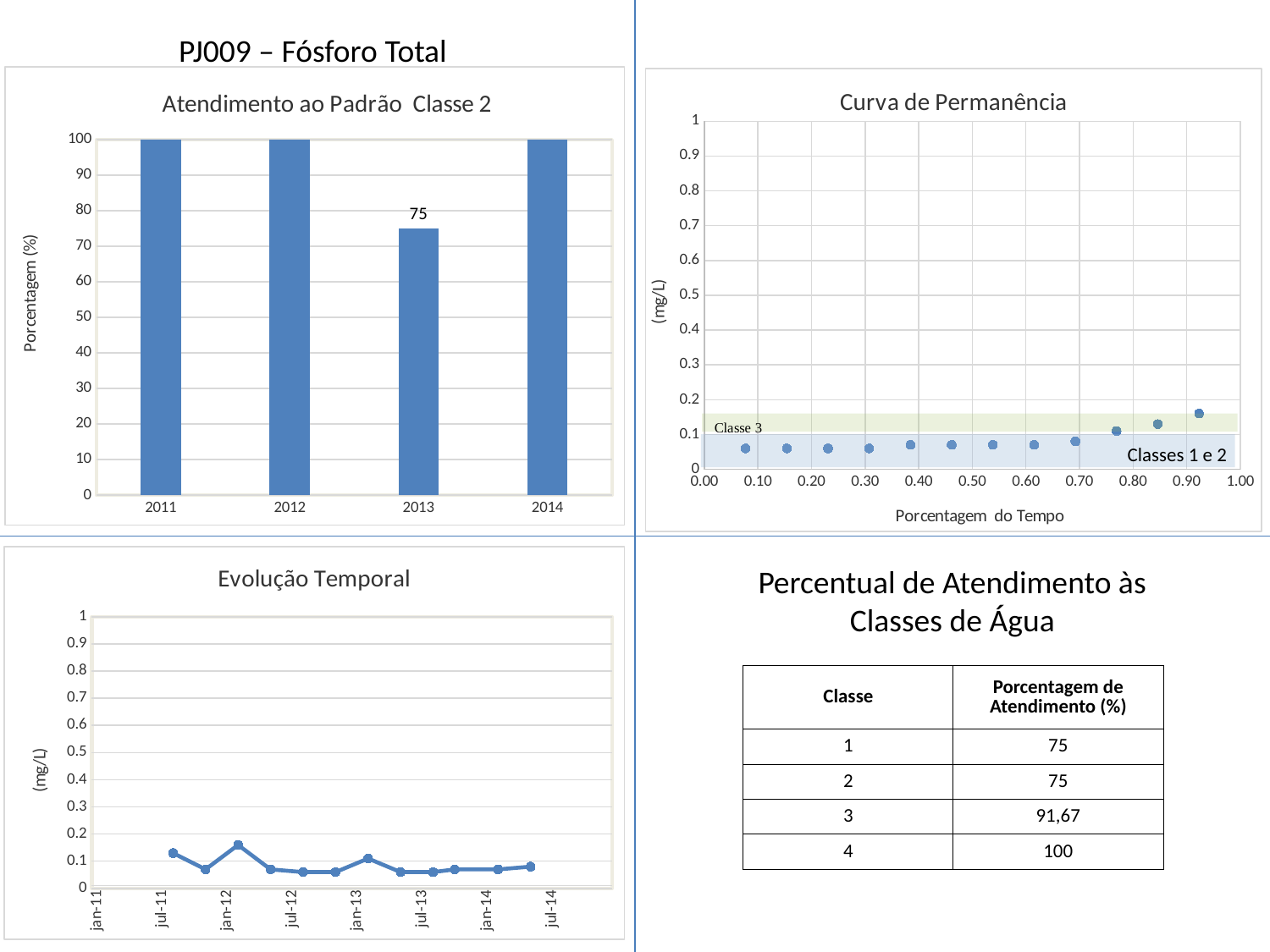
In the 'Atendimento ao Padrão Classe 2' chart, what is the value for 2011? 100 In the 'Atendimento ao Padrão Classe 2' chart, what is the difference between the values for 2012 and 2013? 25 What is the label of the y axis in the 'Evolução Temporal' chart? (mg/L) In the 'Curva de Permanência' chart, is the value of the rightmost point (near 0.92 on the x axis) greater or less than 0.1? greater In the 'Atendimento ao Padrão Classe 2' chart, which year has the lowest value? 2013 In the 'Curva de Permanência' chart, do the values rise or fall as you move along the x axis from left to right? rise In the 'Curva de Permanência' chart, how many data points are plotted? 12 In the 'Evolução Temporal' chart, is the value at jan-12 greater or less than 0.2? less In the 'Atendimento ao Padrão Classe 2' chart, what is the value for 2013? 75 In the 'Atendimento ao Padrão Classe 2' chart, how many years are shown on the x axis? 4 What kind of chart is 'Atendimento ao Padrão Classe 2'? bar chart In the 'Atendimento ao Padrão Classe 2' chart, which is larger, the value for 2013 or the value for 2014? 2014